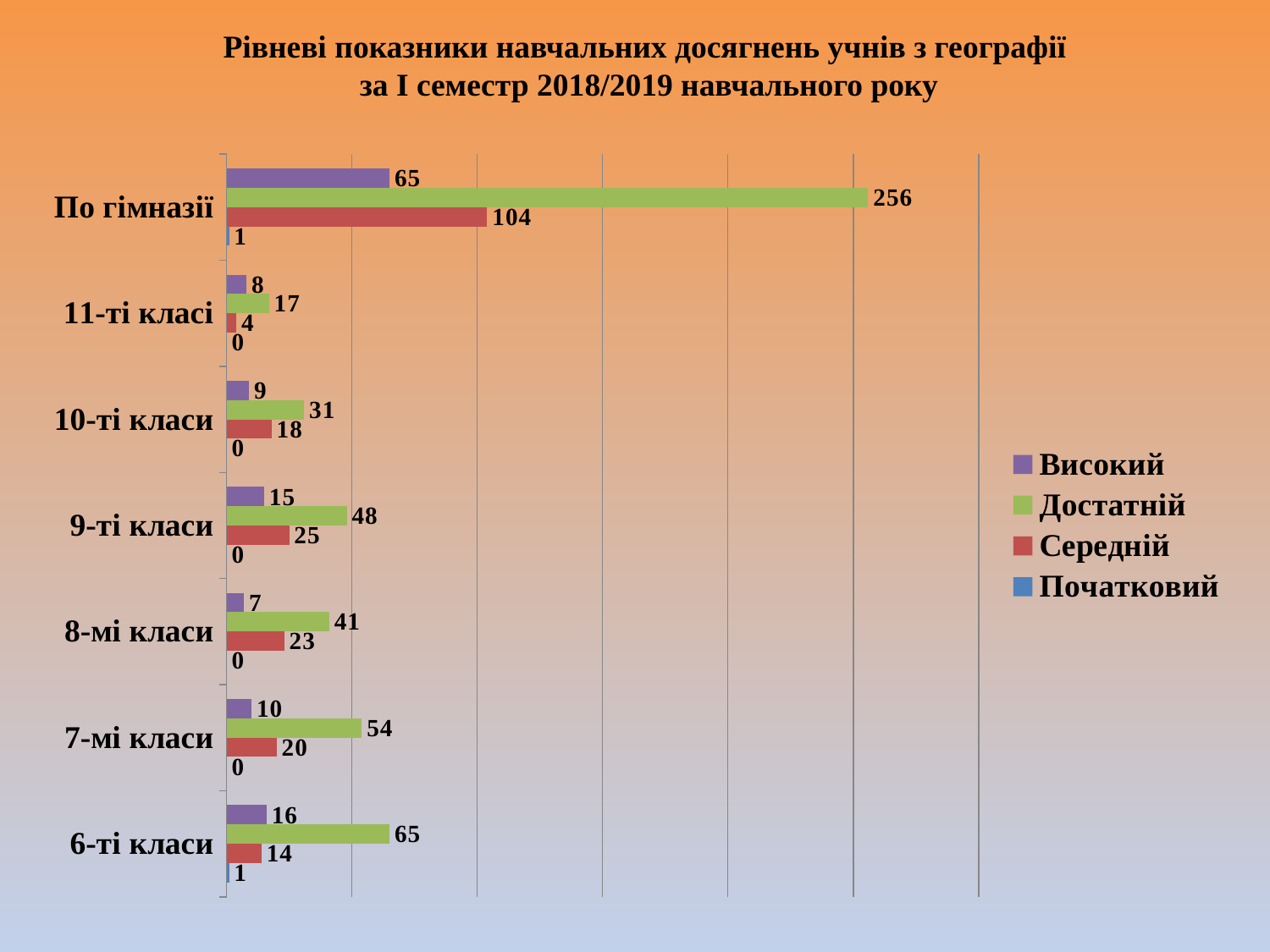
Which category has the highest value for Достатній? По гімназії How many categories are shown on the vertical axis? 7 Which legend entry is shown in green? Достатній What kind of chart is shown on the slide? Bar chart Which is larger: the Високий value for 9-ті класи or the Високий value for 10-ті класи? 9-ті класи What is the value of Початковий for 11-ті класі? 0 Among the class categories (excluding По гімназії), which has the lowest value for Високий? 8-мі класи What is the value of Середній for 9-ті класи? 25 How many series does the legend list? 4 What is the value of Достатній for По гімназії? 256 What is the difference between the Достатній and Середній values for 7-мі класи? 34 What is the value of Високий for 6-ті класи? 16